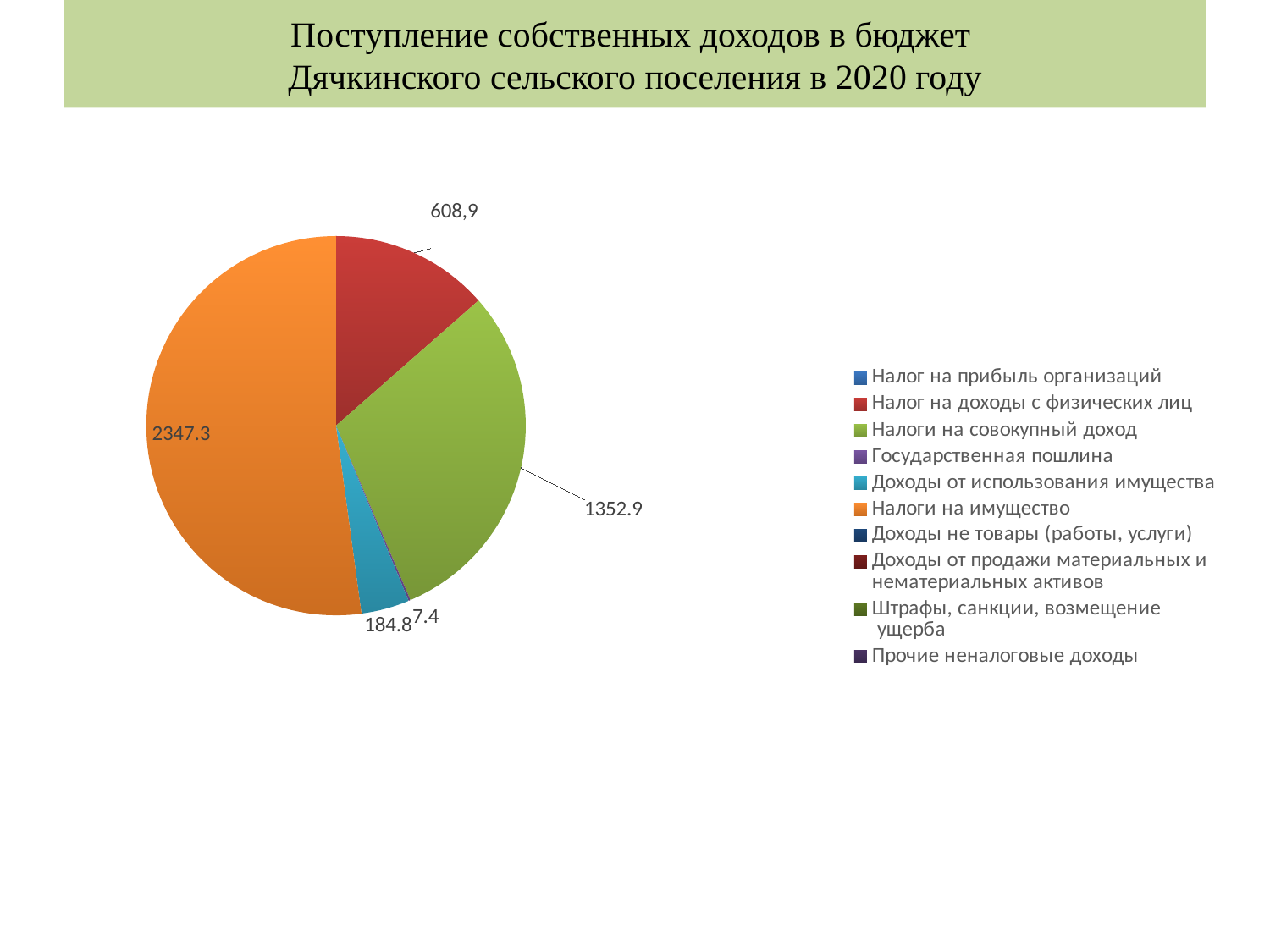
What is the difference between the values for Налоги на имущество and Налоги на совокупный доход? 994.4 How many entries does the legend list? 10 Which labelled category has the smallest slice of the pie? Государственная пошлина What kind of chart is shown on the slide? pie chart What year does the chart title refer to? 2020 Which category has the largest slice of the pie? Налоги на имущество Which is larger: Налоги на совокупный доход or Налог на доходы с физических лиц? Налоги на совокупный доход What is the value shown for Налоги на совокупный доход? 1352.9 What is the value shown for Налоги на имущество? 2347.3 What is the value shown for Государственная пошлина? 7.4 What is the value shown for Доходы от использования имущества? 184.8 What is the value shown for Налог на доходы с физических лиц? 608,9